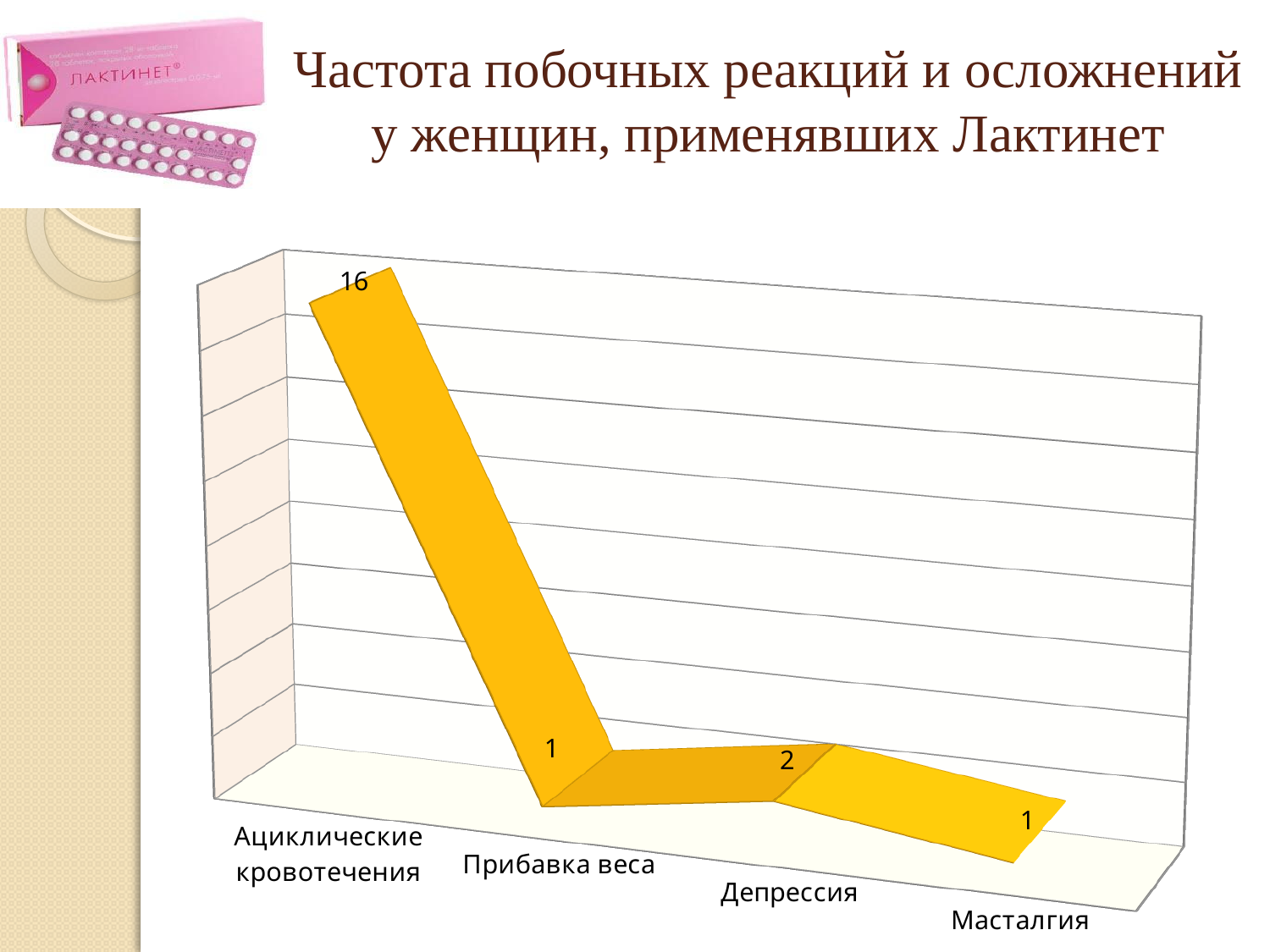
What kind of chart is shown on the slide? line chart What is the difference between the values for Ациклические кровотечения and Прибавка веса? 15 What is the value for Ациклические кровотечения? 16 How many categories are shown on the x axis? 4 Which is larger, the value for Депрессия or the value for Масталгия? Депрессия What is the value for Прибавка веса? 1 Which category has the highest value? Ациклические кровотечения What is the value for Депрессия? 2 What is the value for Масталгия? 1 What is the title of the slide containing the chart? Частота побочных реакций и осложнений у женщин, применявших Лактинет What is the difference between the values for Ациклические кровотечения and Депрессия? 14 Does the value rise or fall from Ациклические кровотечения to Прибавка веса? fall